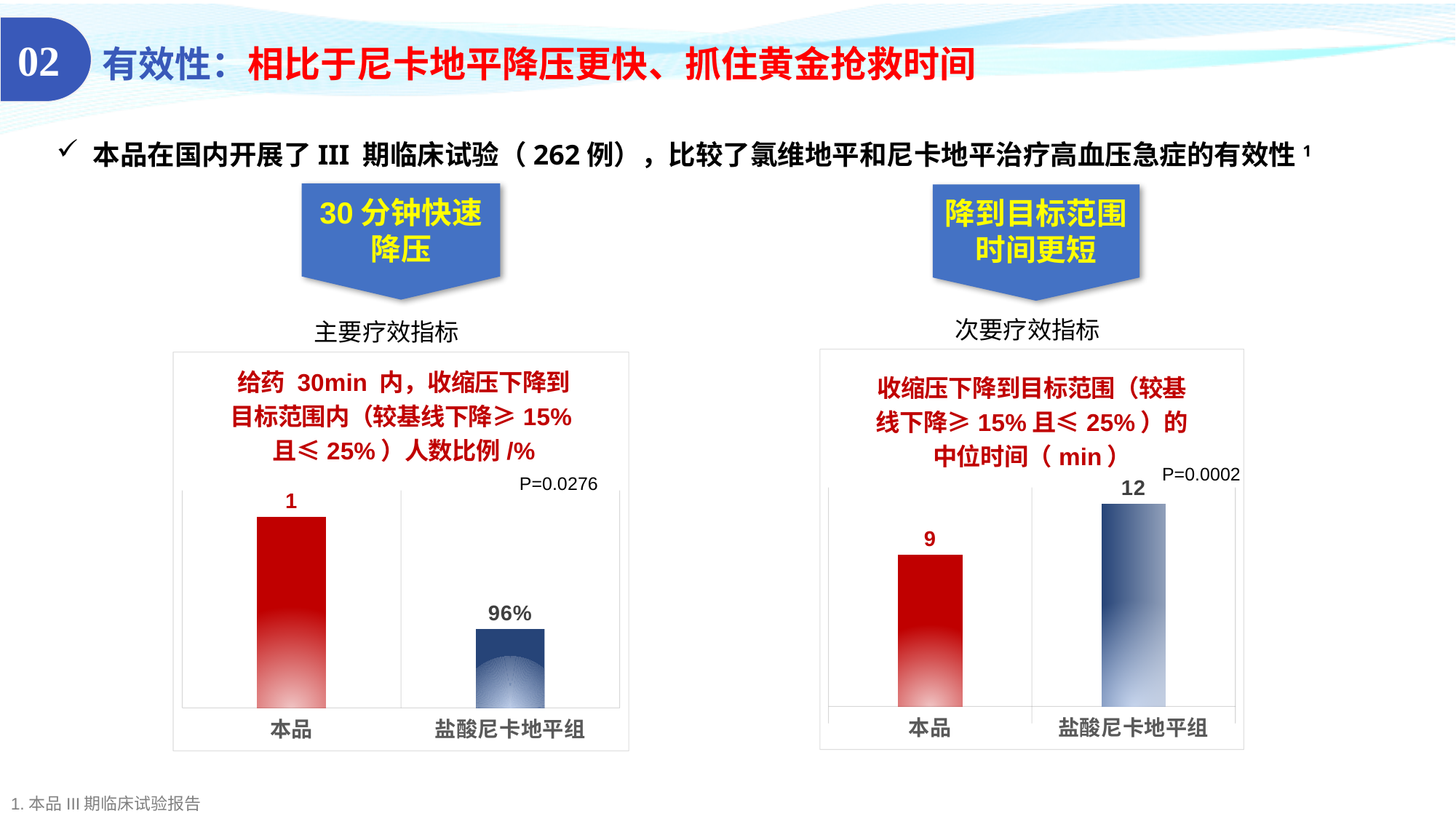
How many bars are shown in the left chart (主要疗效指标)? 2 What P value is printed on the left chart (主要疗效指标)? P=0.0276 What P value is printed on the right chart (次要疗效指标)? P=0.0002 What type of chart is the right chart (次要疗效指标)? Bar chart In the right chart (次要疗效指标), which group has the higher value? 盐酸尼卡地平组 In the left chart (主要疗效指标), what is the value shown for 盐酸尼卡地平组? 96% In the right chart (次要疗效指标), which group has the lower value? 本品 In the right chart (次要疗效指标), what is the value shown for 本品? 9 In the left chart (主要疗效指标), which bar is taller, 本品 or 盐酸尼卡地平组? 本品 In the right chart (次要疗效指标), what is the difference between the values for 盐酸尼卡地平组 and 本品? 3 In the right chart (次要疗效指标), what is the value shown for 盐酸尼卡地平组? 12 In the left chart (主要疗效指标), what is the value shown for 本品? 1